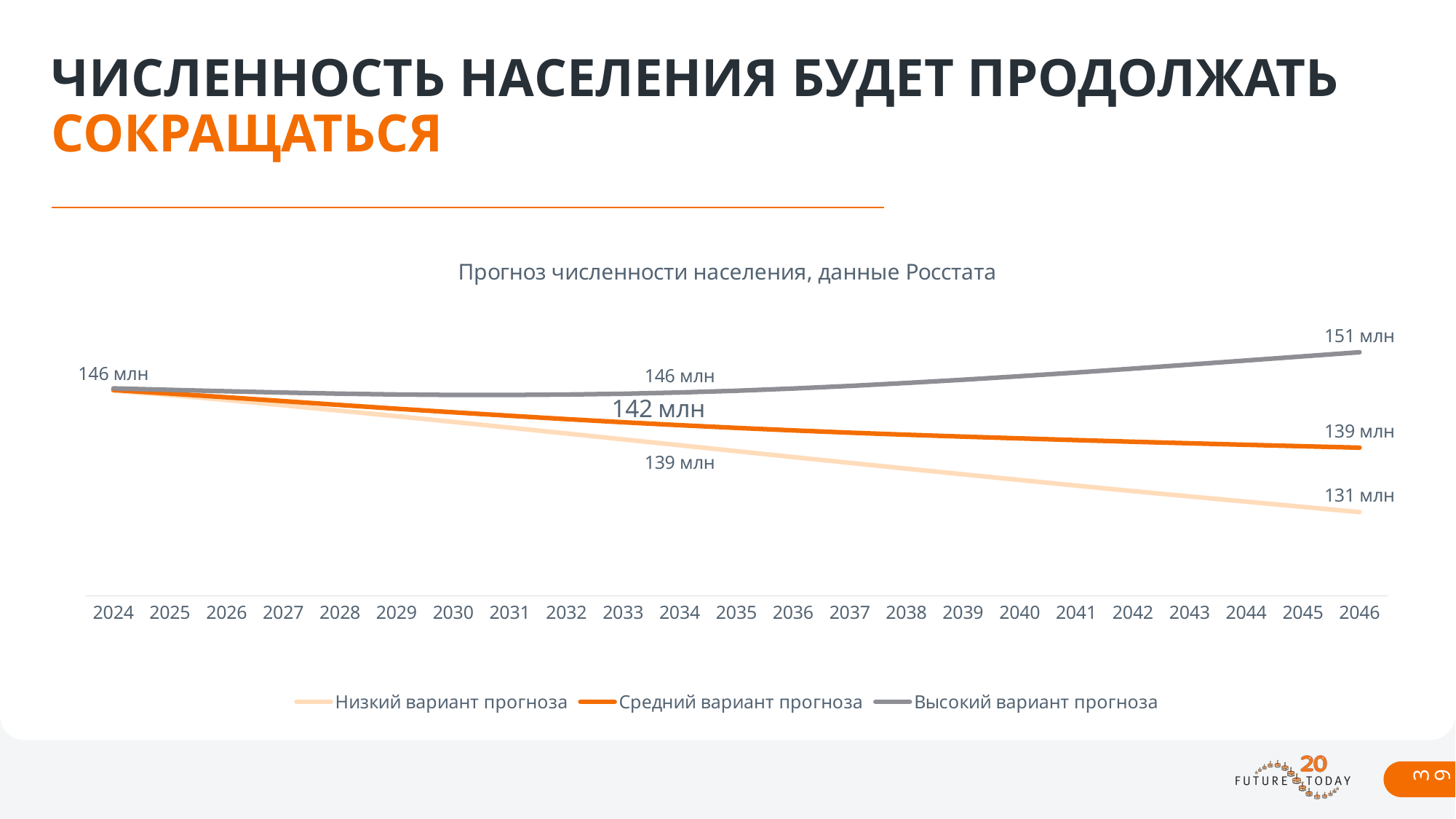
What is the difference between the Высокий and Низкий вариант прогноза values in 2046? 20 млн What is the title of the chart? Прогноз численности населения, данные Росстата What is the value of the Средний вариант прогноза series in 2046? 139 млн Does the Низкий вариант прогноза series rise or fall from 2024 to 2046? fall What type of chart is shown on the slide? line chart What is the value shown for 2024, where all three series start? 146 млн Which series has the lowest value in 2046? Низкий вариант прогноза What is the value of the Низкий вариант прогноза series in 2046? 131 млн What is the value of the Высокий вариант прогноза series in 2046? 151 млн How many series does the legend list? 3 Which series has the highest value in 2046? Высокий вариант прогноза